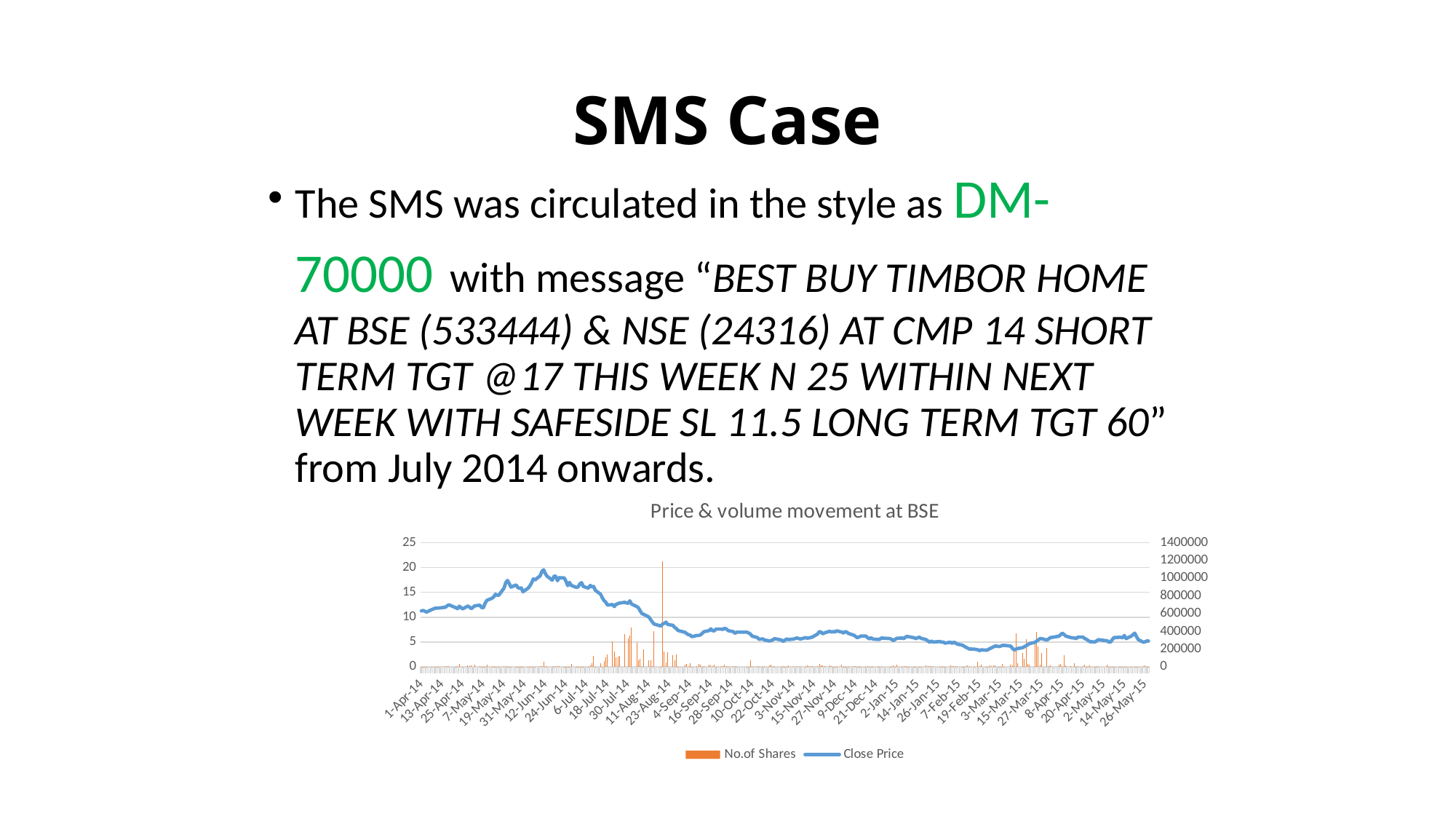
In which month does the largest No.of Shares bar occur? August 2014 Which series is drawn as a line in the chart? Close Price Is the Close Price on 26-May-15 greater or less than 10? less What is the title of the chart? Price & volume movement at BSE Does the Close Price rise or fall between 1-Apr-14 and 12-Jun-14? rise What kind of chart is used for the No.of Shares series? Bar chart What is the highest value shown on the left vertical axis? 25 How many series does the chart legend list? 2 Is the Close Price around 19-Feb-15 greater or less than 5? less Is the Close Price at its peak in June 2014 greater or less than 15? greater